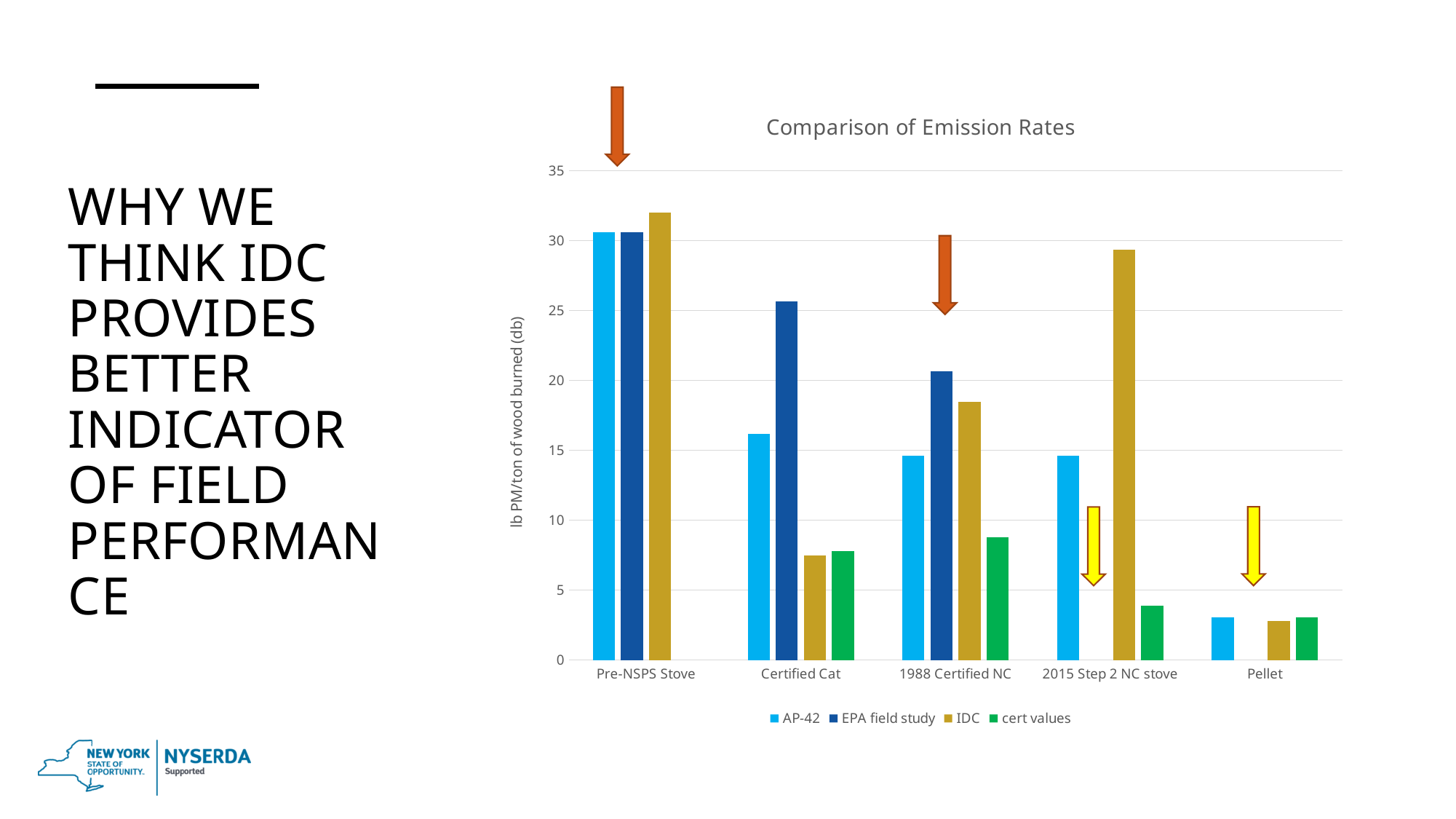
For 1988 Certified NC, which is larger: the IDC value or the cert values value? IDC What is the label on the y axis of the chart? lb PM/ton of wood burned (db) How many stove categories are shown on the x axis of the chart? 5 For Certified Cat, which is larger: the AP-42 value or the EPA field study value? EPA field study Which category has the highest IDC value? Pre-NSPS Stove Is the EPA field study value for Certified Cat greater or less than 20? greater What kind of chart is shown on the slide? bar chart Is the AP-42 value for Pre-NSPS Stove greater or less than 25? greater Which category has the lowest IDC value? Pellet How many series does the legend of the Comparison of Emission Rates chart list? 4 Is the IDC value for 2015 Step 2 NC stove greater or less than 25? greater